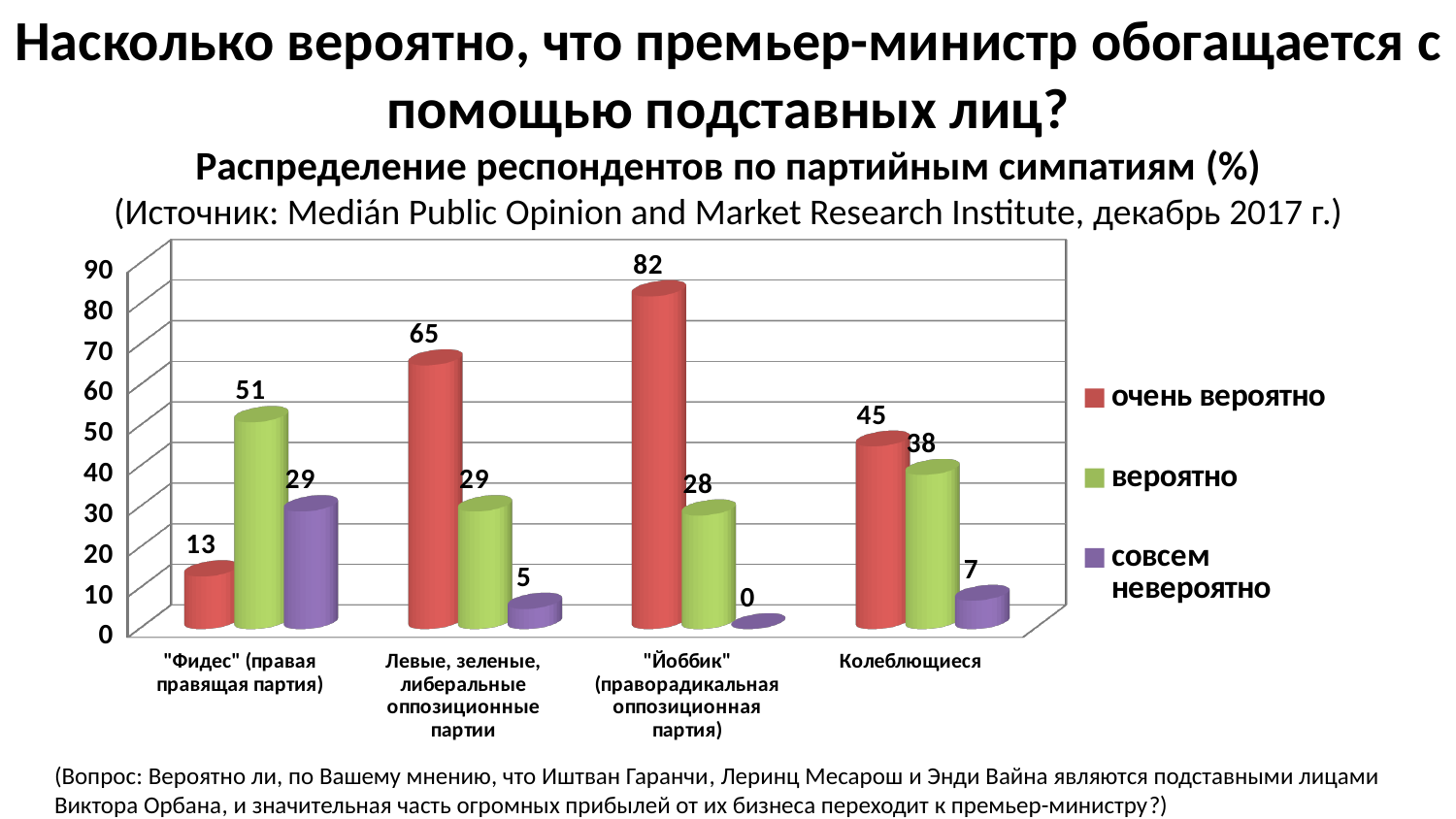
Какое значение серии «вероятно» для категории «Фидес» (правая правящая партия)? 51 Что больше для категории «Колеблющиеся»: значение «очень вероятно» или «вероятно»? очень вероятно Какое значение серии «совсем невероятно» для категории «Левые, зеленые, либеральные оппозиционные партии»? 5 В какой категории значение серии «совсем невероятно» самое низкое? "Йоббик" (праворадикальная оппозиционная партия) Каким цветом на диаграмме показана серия «совсем невероятно»? фиолетовым На сколько значение «очень вероятно» для категории «Левые, зеленые, либеральные оппозиционные партии» больше, чем для категории «Фидес»? 52 Какого типа эта диаграмма? столбчатая (bar chart) Сколько серий перечислено в легенде диаграммы? 3 Какое значение серии «очень вероятно» для категории «Йоббик» (праворадикальная оппозиционная партия)? 82 Сколько категорий (партийных групп) показано на оси x диаграммы? 4 В какой категории значение серии «очень вероятно» самое высокое? "Йоббик" (праворадикальная оппозиционная партия) Какое значение серии «совсем невероятно» для категории «Колеблющиеся»? 7